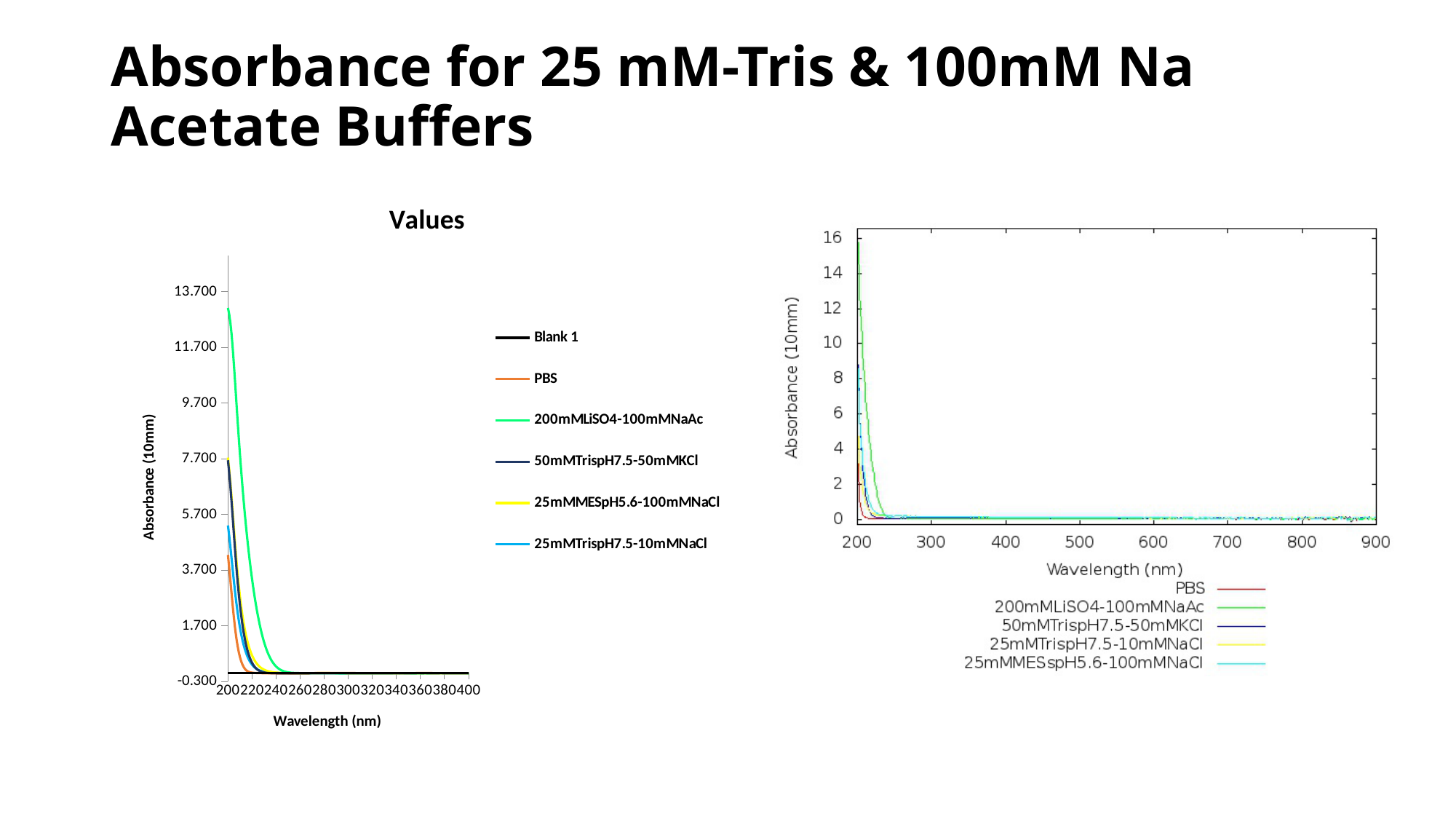
In the right chart, is the peak absorbance of 200mMLiSO4-100mMNaAc greater or less than 14? greater What kind of chart is the left chart titled "Values"? line chart In the left chart titled "Values", is the peak absorbance of 200mMLiSO4-100mMNaAc greater or less than 11.700? greater In the right chart, is the absorbance of PBS at 500 nm greater or less than 2? less In the left chart titled "Values", which series is drawn in black? Blank 1 In the right chart, which series reaches the highest absorbance? 200mMLiSO4-100mMNaAc How many series does the legend of the left chart titled "Values" list? 6 In the left chart titled "Values", which series reaches the highest absorbance? 200mMLiSO4-100mMNaAc What is the x-axis label of the right chart? Wavelength (nm) In the left chart titled "Values", do the absorbance values rise or fall as wavelength increases from 200 nm to 400 nm? fall How many series does the legend of the right chart list? 5